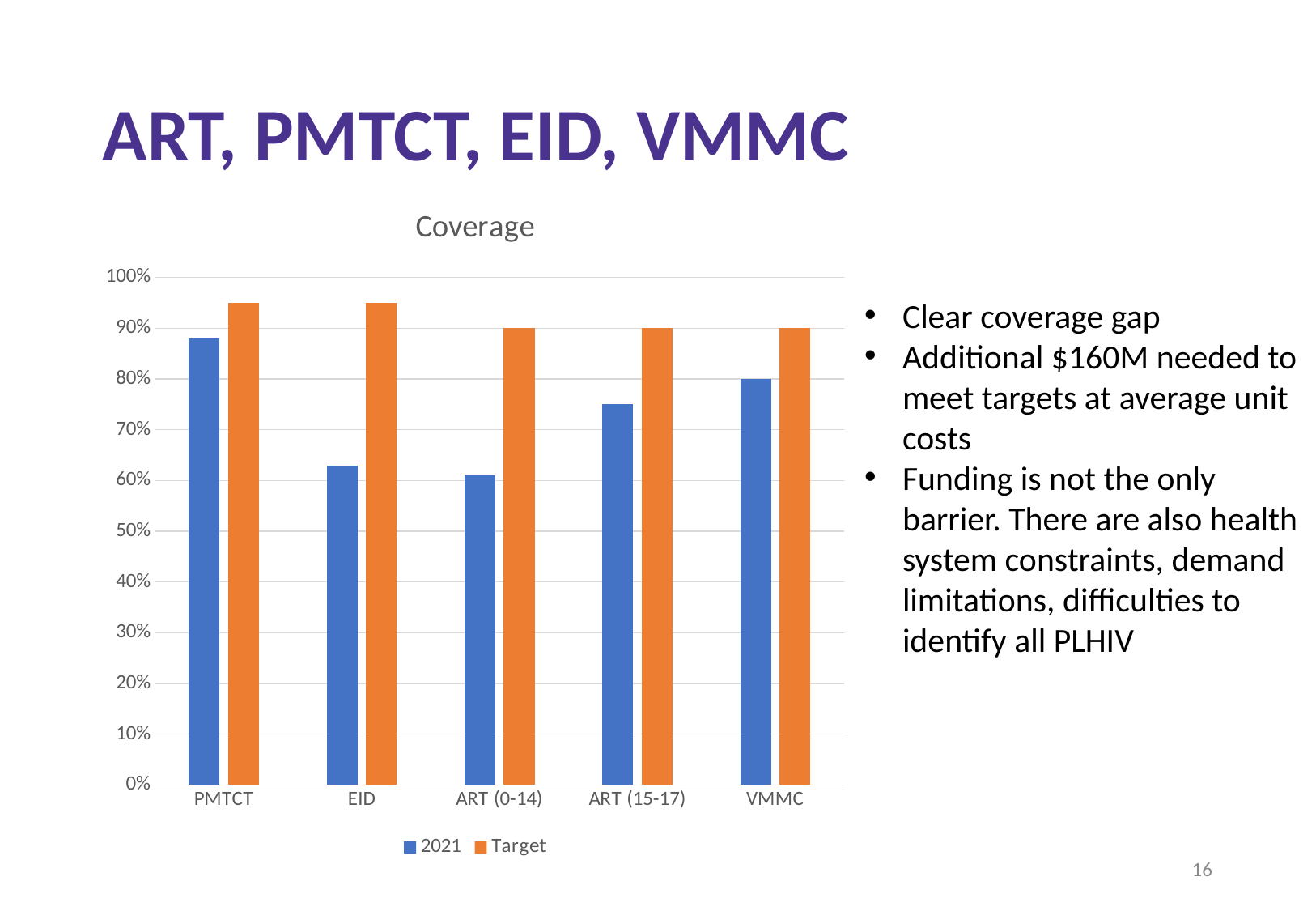
Which is larger, the 2021 value for EID or the Target value for EID? Target Which series is shown in orange in the Coverage chart? Target Is the 2021 value for PMTCT greater or less than 80%? greater How many series does the legend of the Coverage chart list? 2 Is the 2021 value for ART (0-14) greater or less than 70%? less Which category has the highest 2021 value in the Coverage chart? PMTCT How many categories are shown on the x axis of the Coverage chart? 5 What is the title of the chart? Coverage Which is larger, the 2021 value for PMTCT or the 2021 value for VMMC? PMTCT Is the 2021 value for ART (15-17) greater or less than 70%? greater What kind of chart is shown on the slide? bar chart